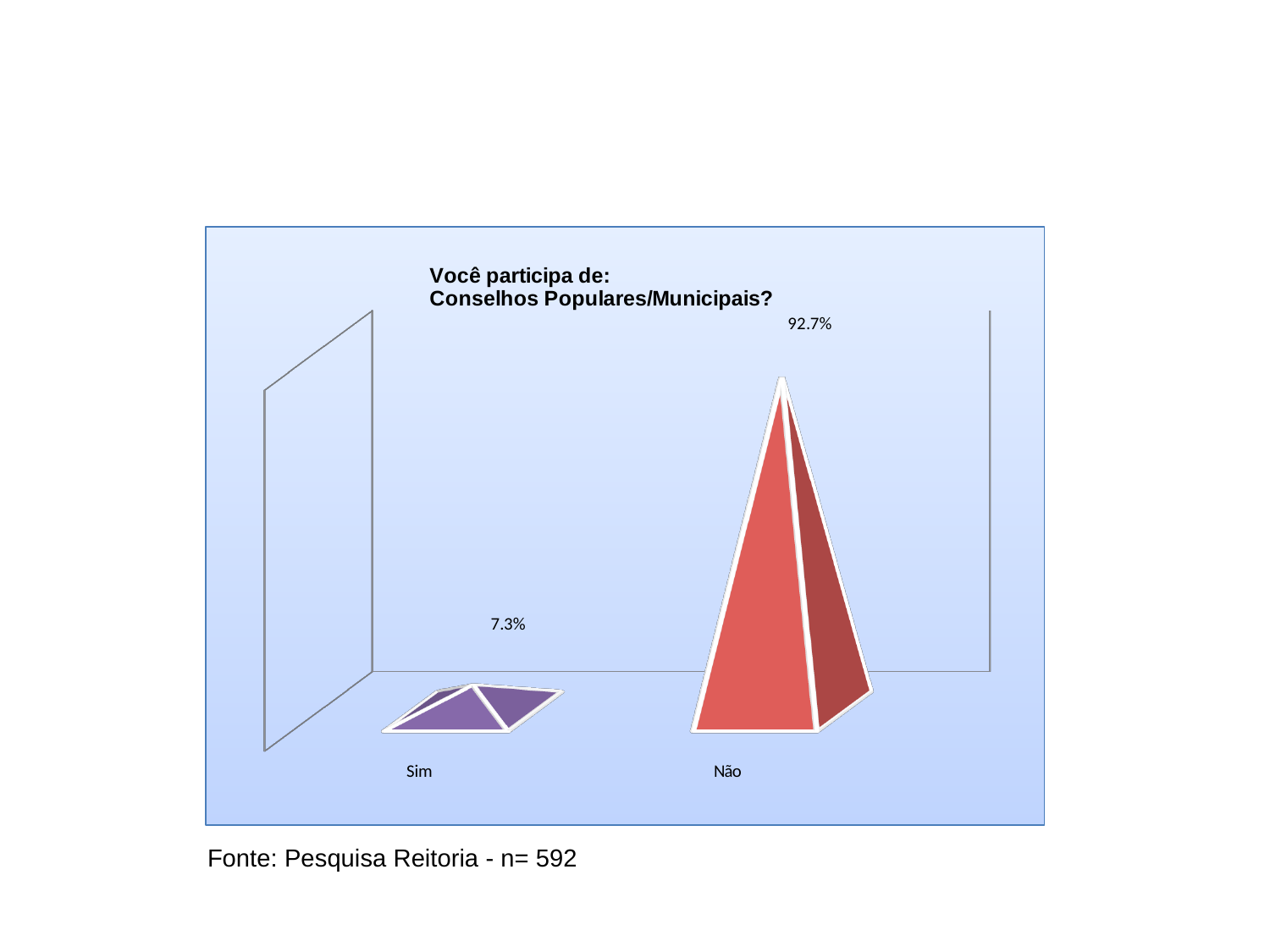
What kind of chart is shown on the slide? Bar chart Which category has the lowest value? Sim What is the title of the chart? Você participa de: Conselhos Populares/Municipais? What is the value for Não? 92.7% Which is larger, the value for Sim or the value for Não? Não Which category has the highest value? Não What is the value for Sim? 7.3% How many categories are shown in the chart? 2 What colour is the bar for Não? Red What is the sample size (n) given in the source note below the chart? 592 What is the difference between the values for Não and Sim? 85.4%